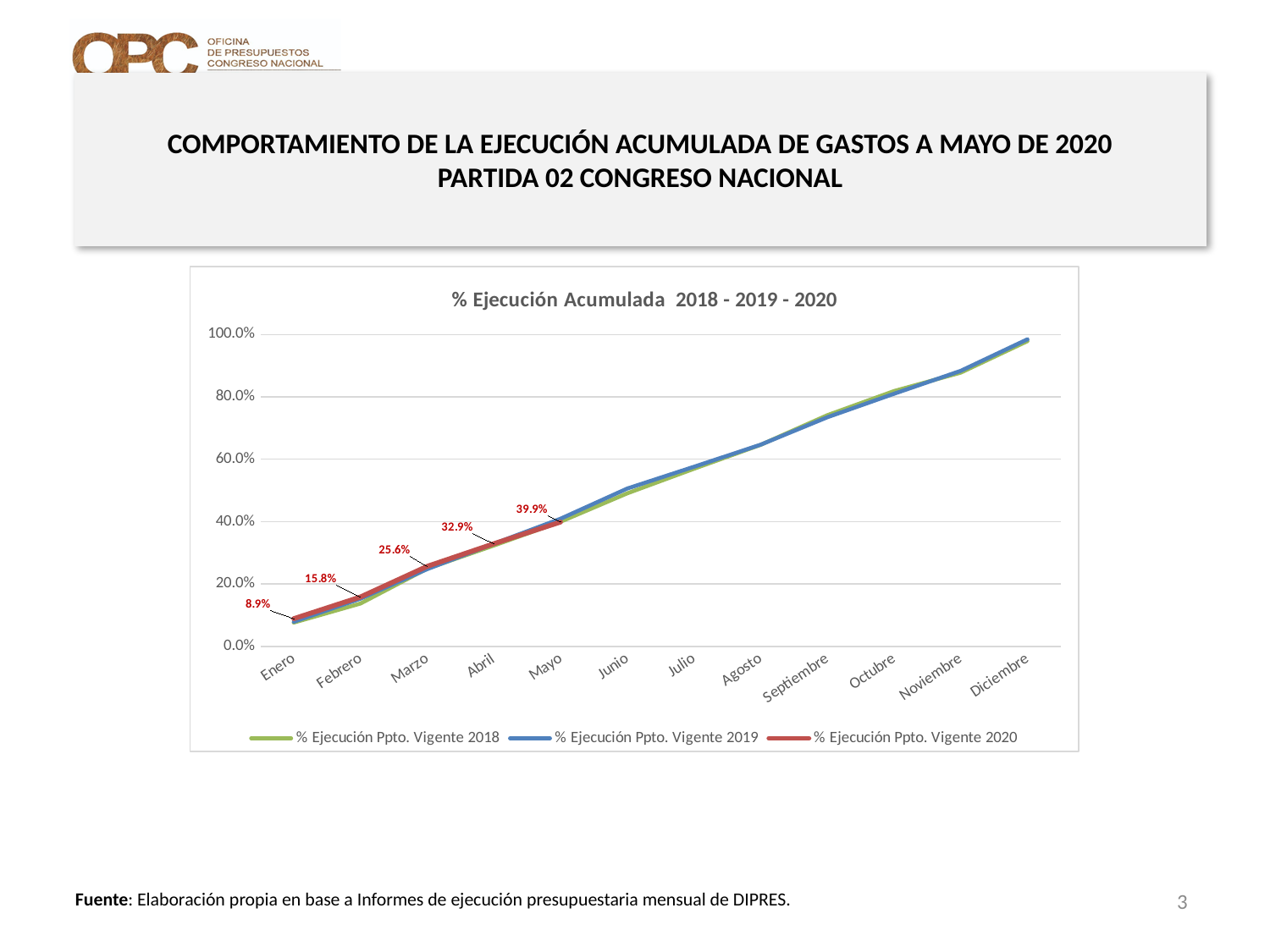
What is the value for Mayo in the % Ejecución Ppto. Vigente 2020 series? 39.9% What kind of chart is shown on the slide? Line chart What is the value for Marzo in the % Ejecución Ppto. Vigente 2020 series? 25.6% Is the value for Diciembre in the % Ejecución Ppto. Vigente 2019 series greater or less than 80.0%? greater What is the value for Abril in the % Ejecución Ppto. Vigente 2020 series? 32.9% How many months are shown on the x axis of the chart? 12 Do the values in the % Ejecución Ppto. Vigente 2019 series rise or fall from Enero to Diciembre? Rise What is the title of the chart? % Ejecución Acumulada 2018 - 2019 - 2020 What is the difference between the Mayo and Enero values in the % Ejecución Ppto. Vigente 2020 series? 31.0% How many series does the chart legend list? 3 What is the value for Enero in the % Ejecución Ppto. Vigente 2020 series? 8.9% What is the difference between the Marzo and Febrero values in the % Ejecución Ppto. Vigente 2020 series? 9.8%